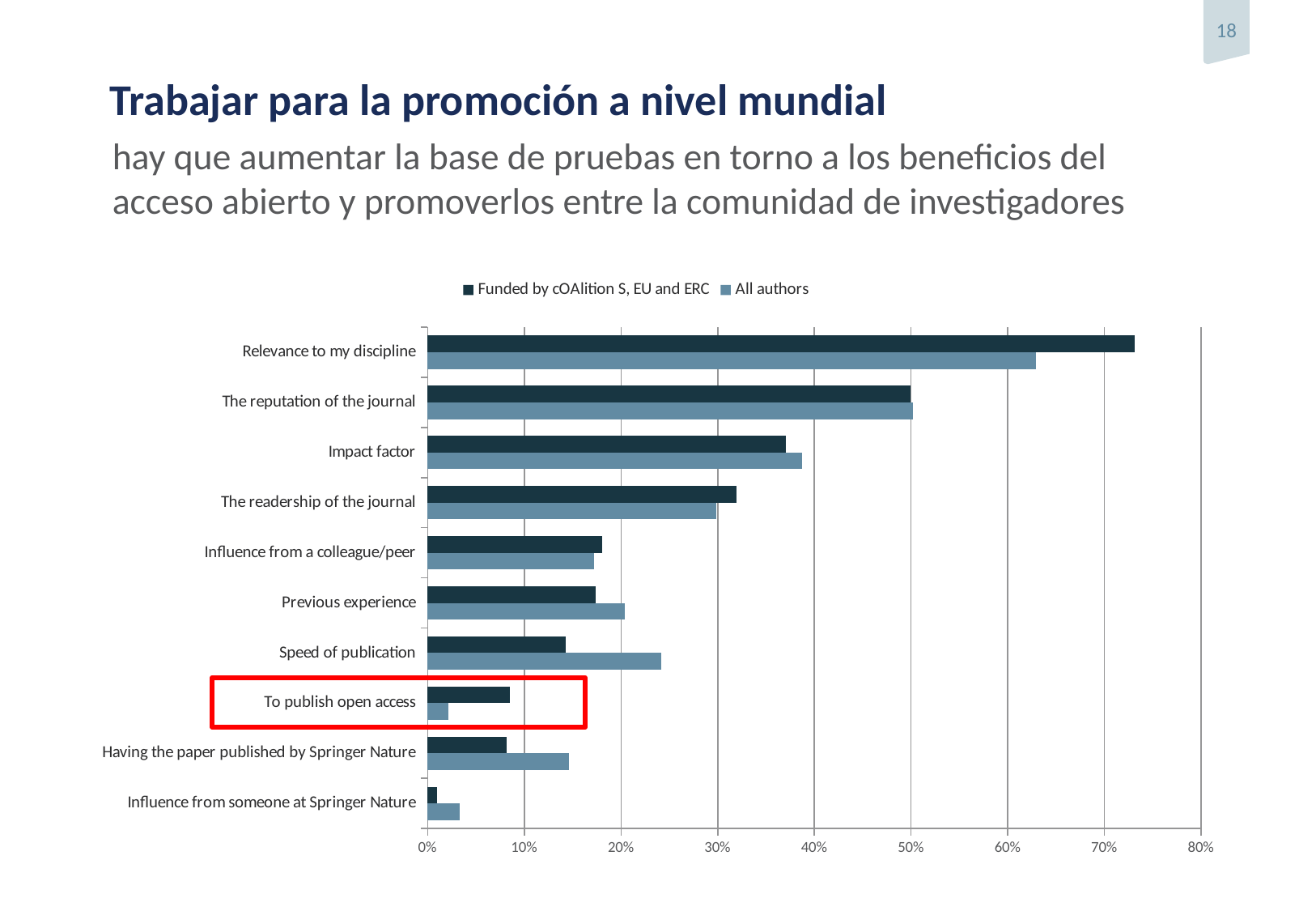
Is the 'Funded by cOAlition S, EU and ERC' value for 'Relevance to my discipline' greater or less than 70%? greater Is the 'All authors' value for 'Speed of publication' greater or less than 20%? greater Is the 'All authors' value for 'To publish open access' greater or less than 10%? less How many categories are plotted on the chart? 10 Which category has the lowest value for the 'Funded by cOAlition S, EU and ERC' series? Influence from someone at Springer Nature Which category has the highest value for the 'Funded by cOAlition S, EU and ERC' series? Relevance to my discipline Which category on the chart is highlighted with a red box? To publish open access For 'Speed of publication', which series has the larger value? All authors For 'To publish open access', which series has the larger value? Funded by cOAlition S, EU and ERC How many series does the chart legend list? 2 What kind of chart is shown on the slide? bar chart